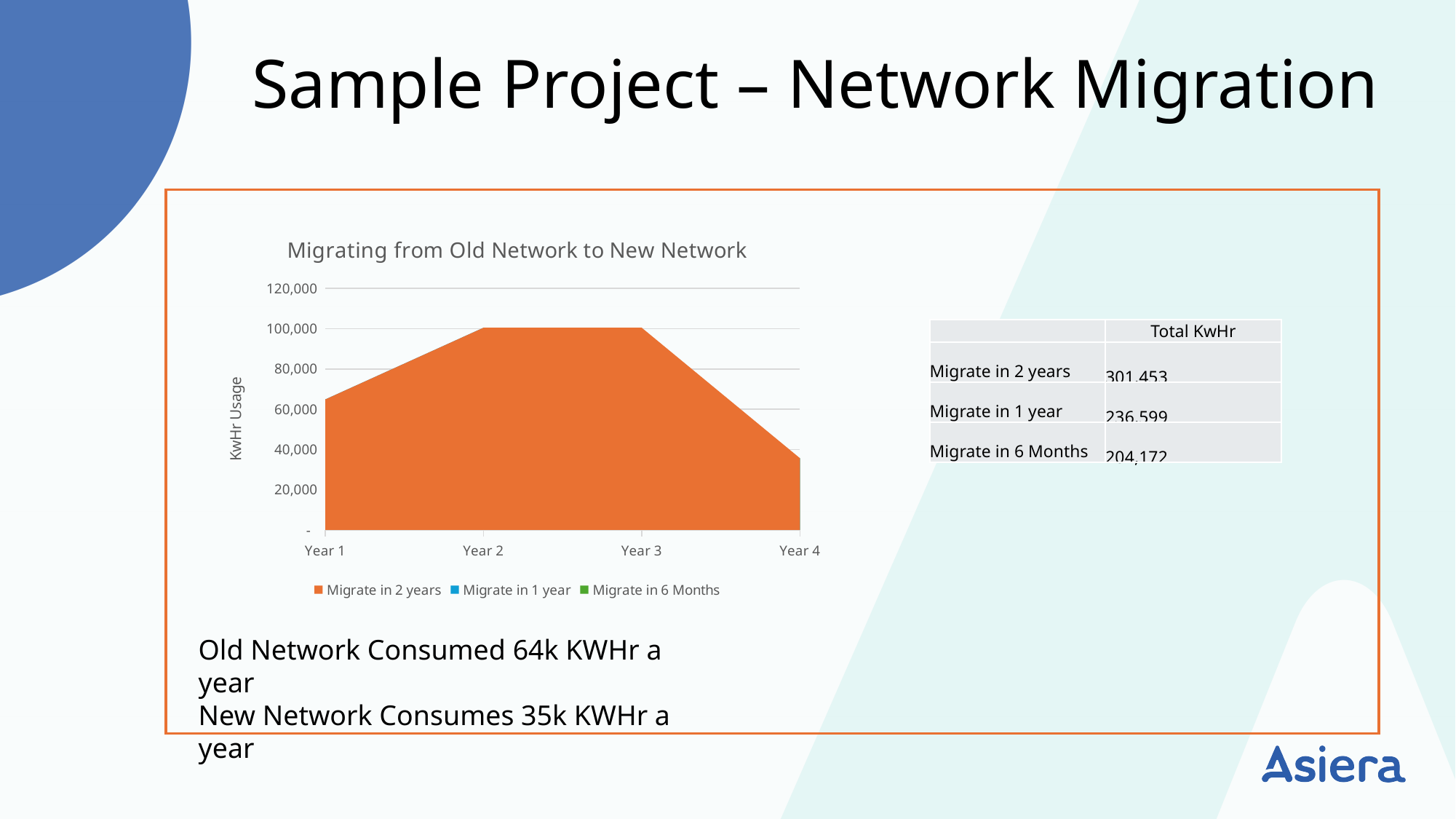
Does the KwHr usage rise or fall from Year 3 to Year 4? Fall Does the KwHr usage rise or fall from Year 1 to Year 2? Rise Which has the larger KwHr usage in the chart, Year 1 or Year 4? Year 1 What is the label on the vertical axis of the chart? KwHr Usage What kind of chart is shown on the slide? Area chart How many series does the legend of the chart list? 3 What is the title of the chart? Migrating from Old Network to New Network Is the value for Year 1 in the Migrate in 2 years series greater or less than 60,000? greater Which year has the lowest KwHr usage in the chart? Year 4 Is the value for Year 2 in the Migrate in 2 years series greater or less than 80,000? greater Is the value for Year 4 in the Migrate in 2 years series greater or less than 40,000? less How many years are shown along the x axis of the chart? 4